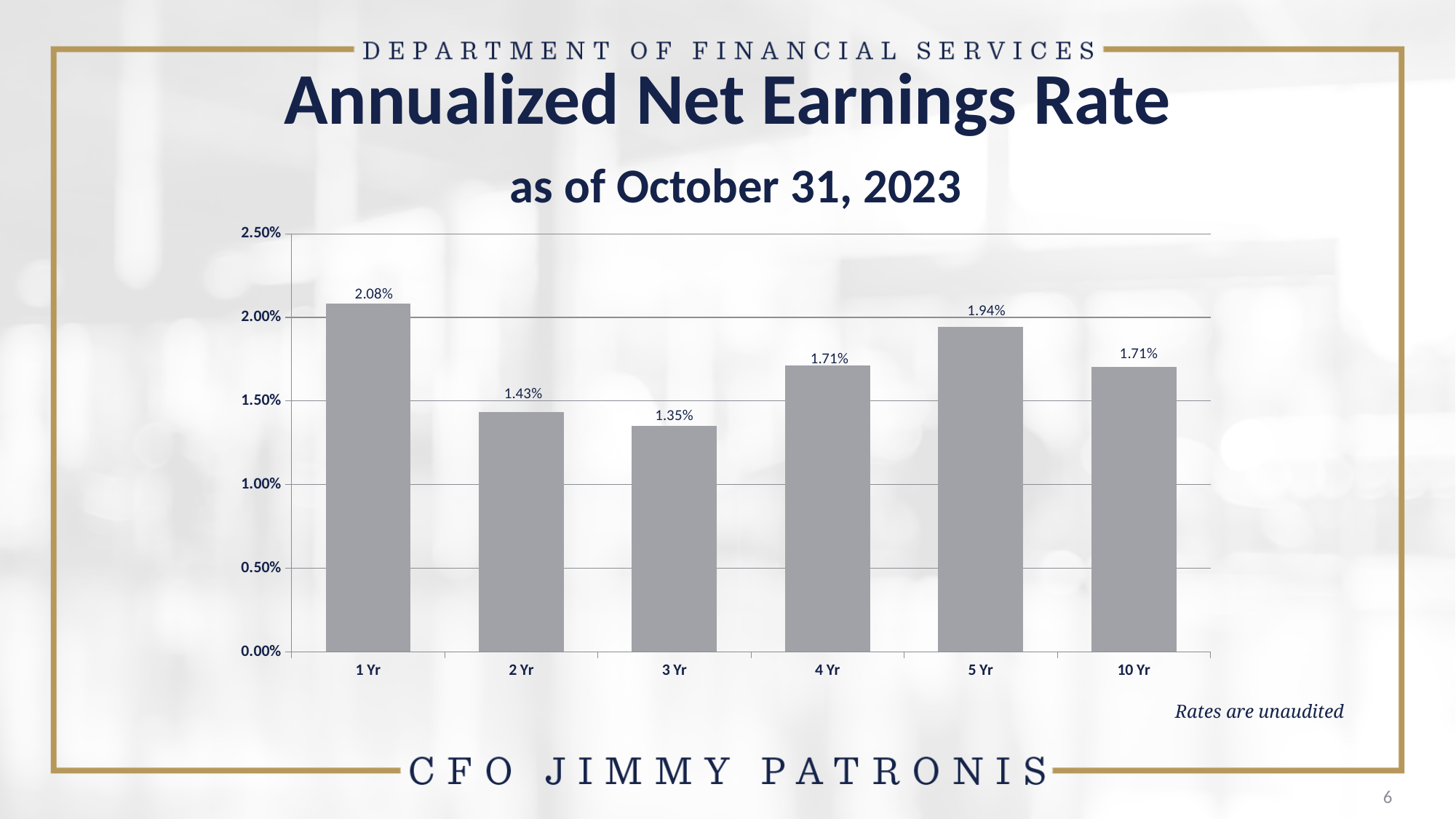
What is the difference between the 1 Yr rate and the 2 Yr rate? 0.65% What is the annualized net earnings rate for 10 Yr? 1.71% Which period has the lowest annualized net earnings rate? 3 Yr Is the value for 5 Yr greater or less than 2.00%? less How many periods are shown on the chart? 6 As of what date are the annualized net earnings rates reported? October 31, 2023 What is the annualized net earnings rate for 5 Yr? 1.94% Which period has the highest annualized net earnings rate? 1 Yr What is the annualized net earnings rate for 3 Yr? 1.35% What kind of chart is shown on the slide? bar chart What is the annualized net earnings rate for 1 Yr? 2.08% Which is larger, the rate for 2 Yr or the rate for 4 Yr? 4 Yr